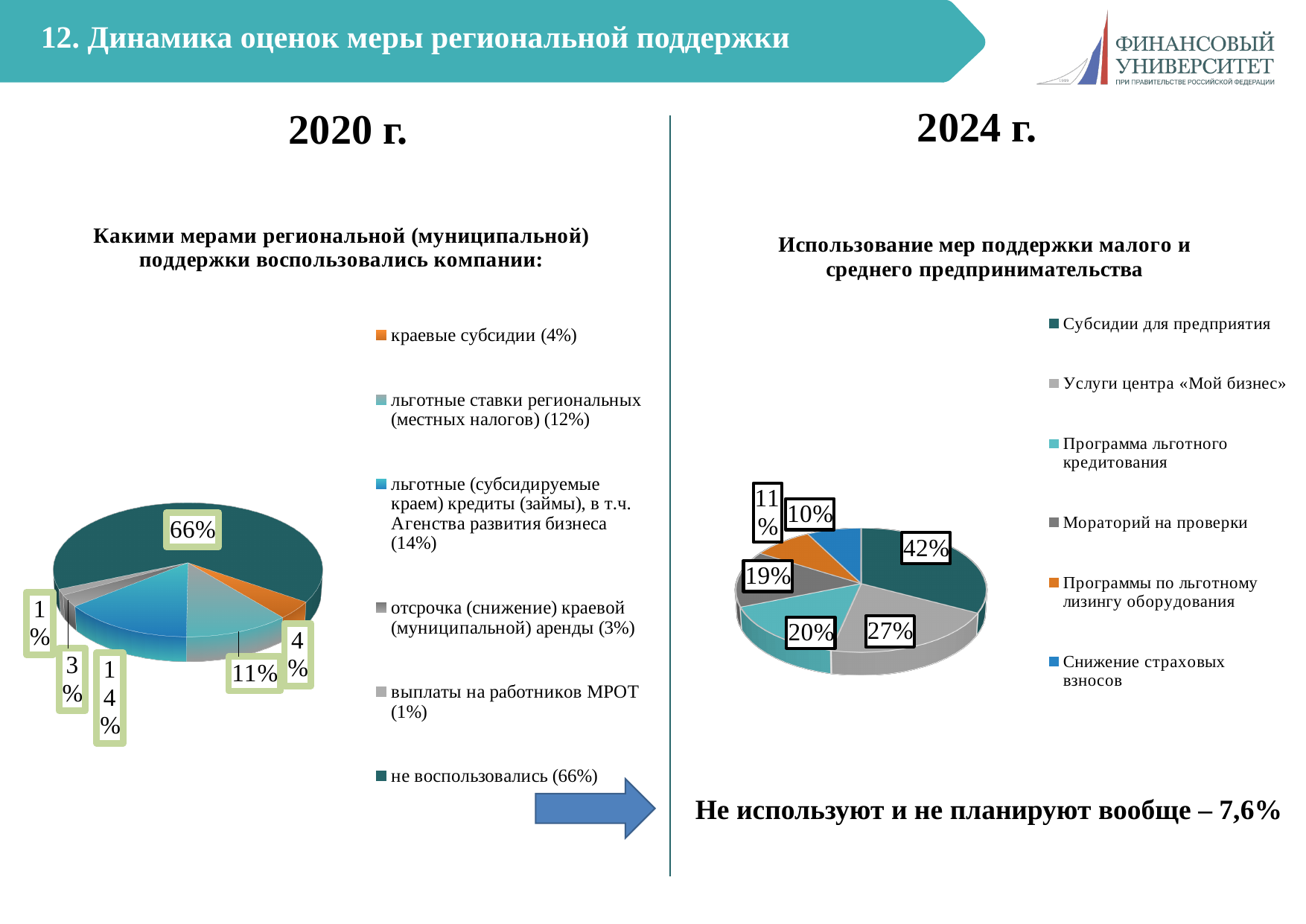
In the 2024 pie chart, what is the value for Субсидии для предприятия? 42% In the 2024 pie chart, what is the difference between Субсидии для предприятия and Программа льготного кредитования? 22% In the 2024 pie chart, which is larger: Мораторий на проверки or Снижение страховых взносов? Мораторий на проверки In the 2024 pie chart, which category has the largest share? Субсидии для предприятия In the 2020 pie chart, what share of companies did not use any regional support measures (не воспользовались)? 66% How many categories does the legend of the 2024 pie chart list? 6 How many categories does the legend of the 2020 pie chart list? 6 In the 2020 pie chart, what is the value for краевые субсидии? 4% What type of chart is used on the left side of the slide for 2020? pie chart In the 2020 pie chart, what is the value for льготные (субсидируемые краем) кредиты (займы)? 14% In the 2020 pie chart, which category has the smallest share? выплаты на работников МРОТ In the 2024 pie chart, what is the value for Услуги центра «Мой бизнес»? 27%